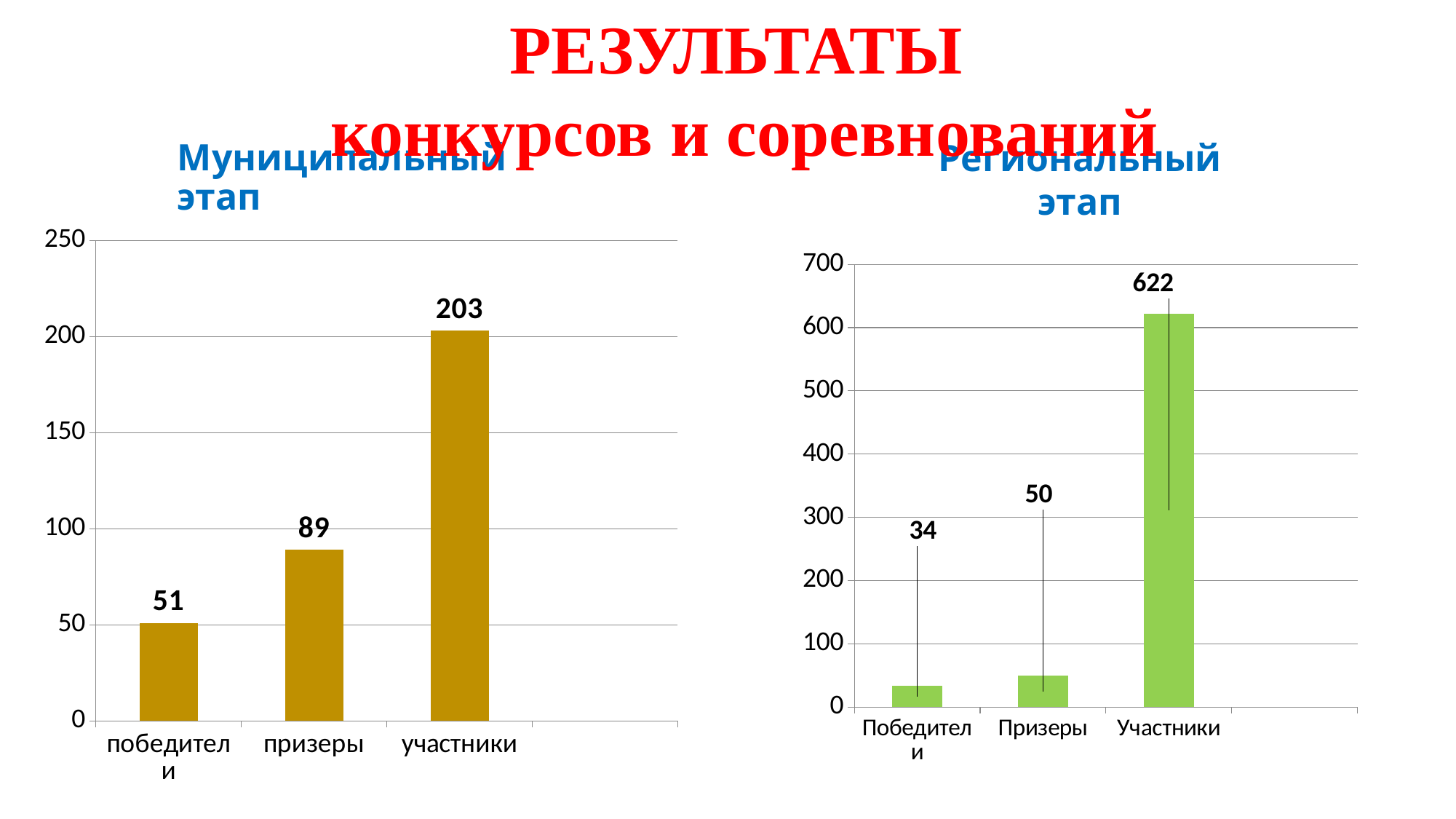
In the 'Региональный этап' chart, what is the value for Участники? 622 In the 'Муниципальный этап' chart, what is the value for призеры? 89 What type of chart is the 'Муниципальный этап' chart? bar chart In the 'Муниципальный этап' chart, which category has the lowest value? победители In the 'Региональный этап' chart, what is the value for Победители? 34 How many categories does the 'Региональный этап' chart show? 3 In the 'Региональный этап' chart, which category has the highest value? Участники In the 'Муниципальный этап' chart, what is the difference between участники and призеры? 114 In the 'Региональный этап' chart, do the values rise or fall from left to right? rise In the 'Муниципальный этап' chart, what is the value for участники? 203 Which is larger: призеры in the 'Муниципальный этап' chart or Призеры in the 'Региональный этап' chart? призеры in the Муниципальный этап chart In the 'Региональный этап' chart, what is the difference between Призеры and Победители? 16